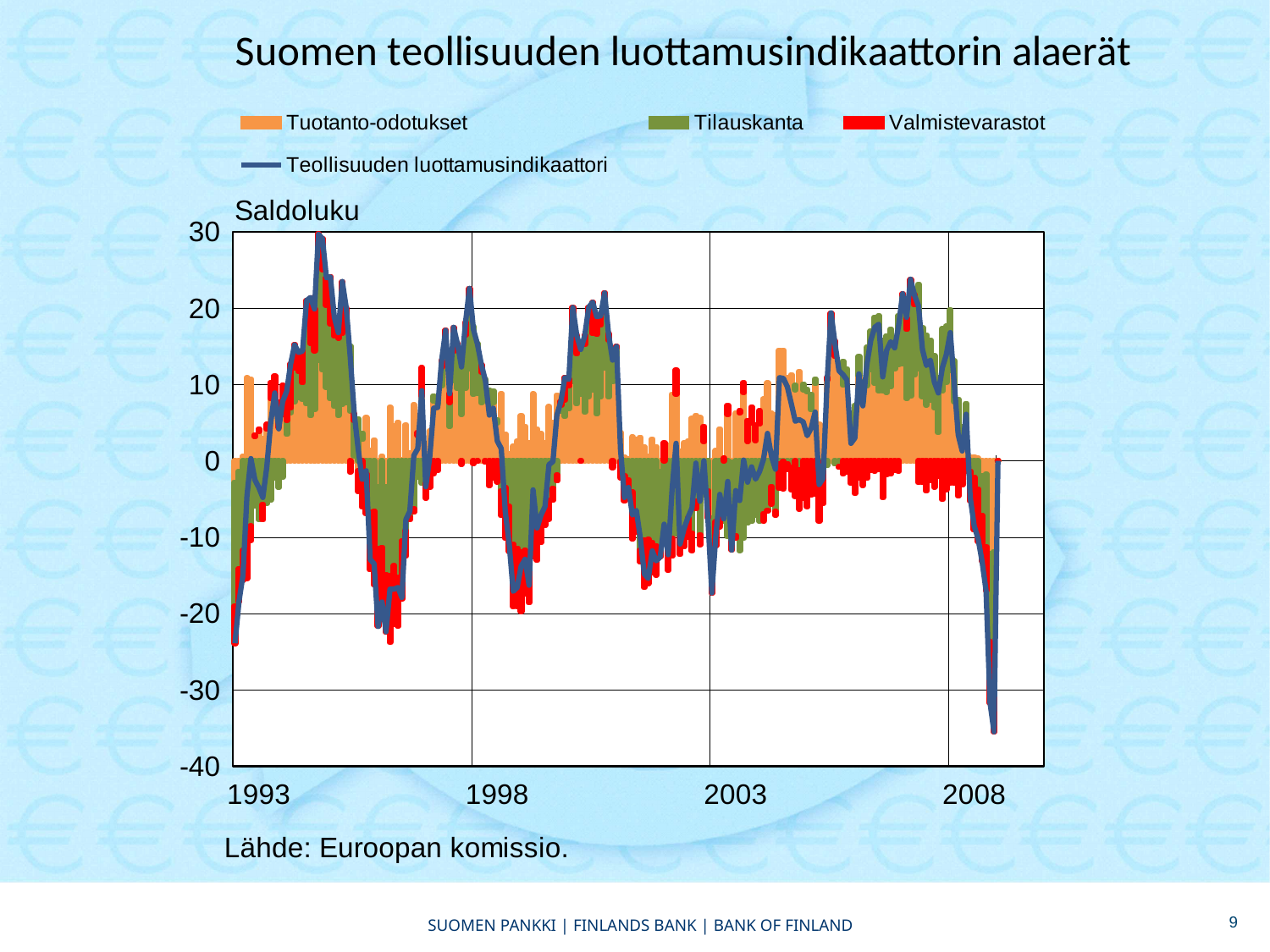
Is the lowest point of the Teollisuuden luottamusindikaattori line, reached after 2008, greater or less than -30? less How many series does the chart's legend list? 4 What is the first year label on the horizontal axis of the chart? 1993 What source is cited below the chart? Euroopan komissio What is the last year label on the horizontal axis of the chart? 2008 What is the label shown on the vertical axis of the chart? Saldoluku What is the lowest value shown on the vertical axis of the chart? -40 What is the highest value shown on the vertical axis of the chart? 30 Which series in the legend is drawn as a line rather than bars? Teollisuuden luottamusindikaattori Is the highest peak of the Teollisuuden luottamusindikaattori line, reached between 1993 and 1998, greater or less than 20? greater How many year labels are shown on the horizontal axis of the chart? 4 What is the title of the chart on the slide? Suomen teollisuuden luottamusindikaattorin alaerät